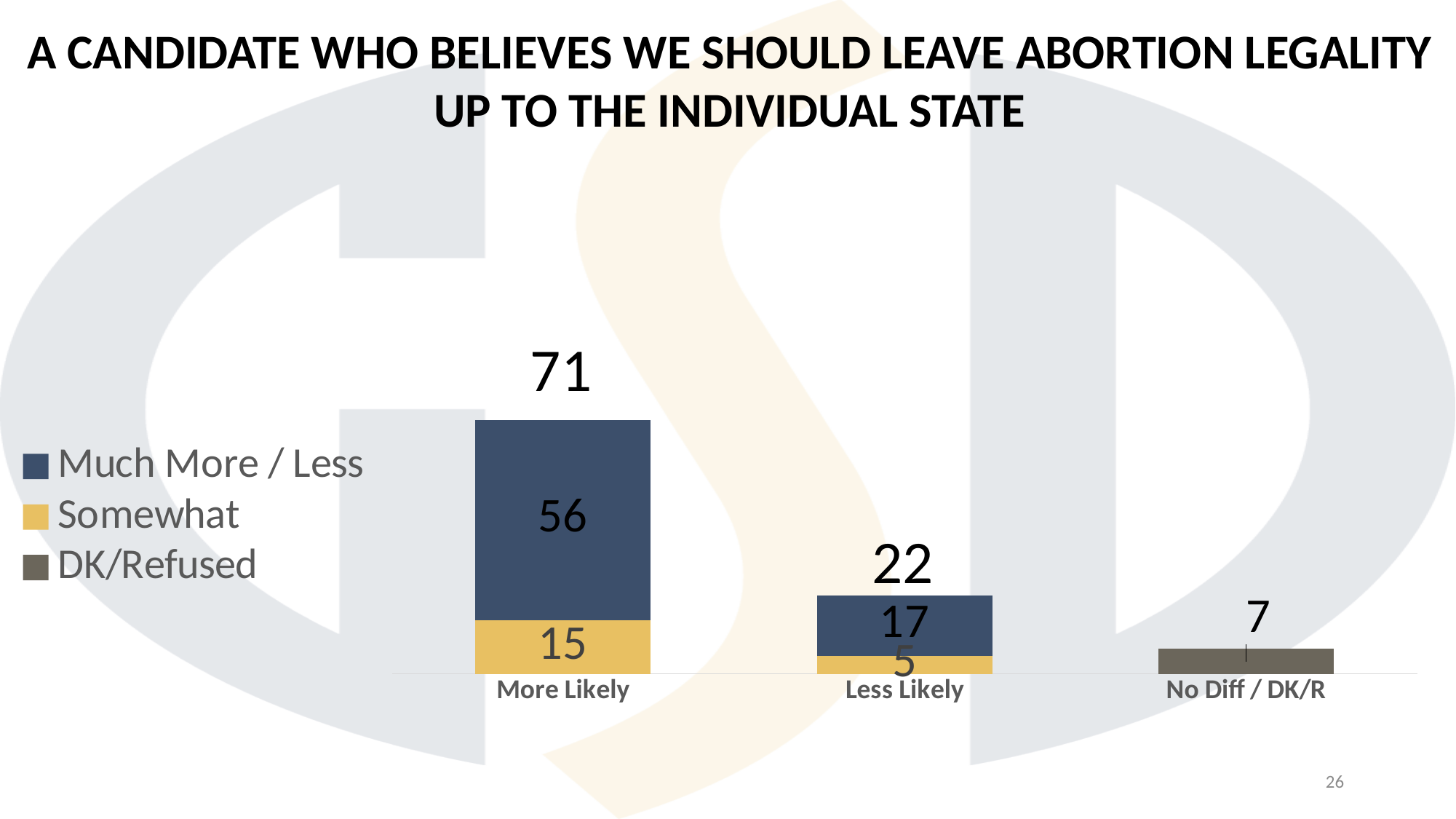
What is the 'Somewhat' value for the Less Likely bar? 5 What is the difference between the More Likely total and the Less Likely total? 49 How many series does the legend list? 3 Which is larger: the 'Somewhat' value for More Likely or the 'Somewhat' value for Less Likely? More Likely What is the 'Much More / Less' value for the More Likely bar? 56 What is the total of the More Likely stacked bar? 71 What is the value shown for the No Diff / DK/R bar? 7 Which category has the lowest total? No Diff / DK/R What is the total of the Less Likely stacked bar? 22 Which category has the highest total? More Likely How many categories are shown on the x axis? 3 What kind of chart is shown on the slide? Stacked bar chart